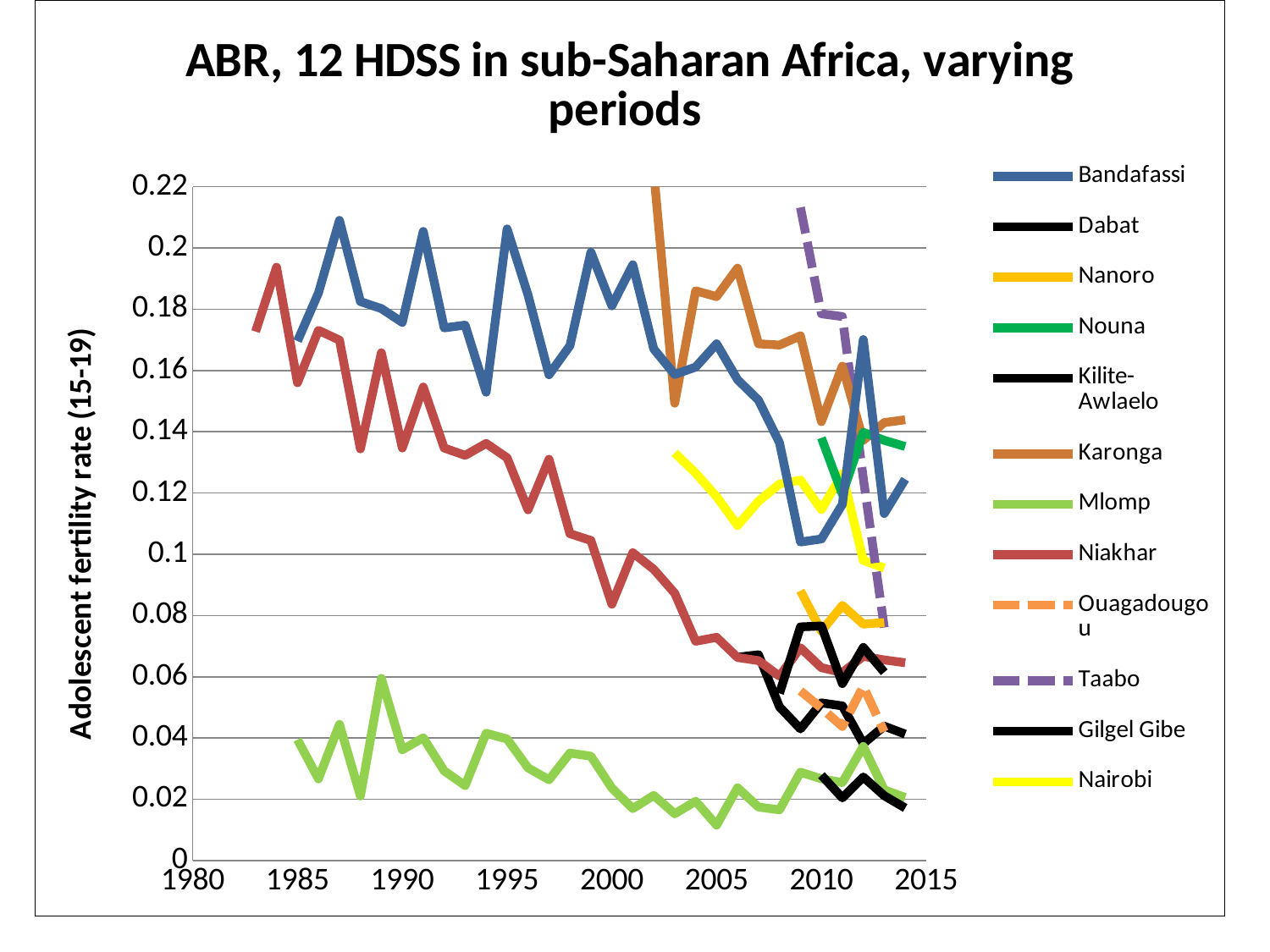
Is the value for Niakhar in 1984 greater or less than 0.18? greater Is the value for Nairobi in 2003 greater or less than 0.12? greater In 2000, which series has the larger value, Bandafassi or Niakhar? Bandafassi Is the value for Bandafassi in 2009 greater or less than 0.12? less What kind of chart is shown on the slide? Line chart Does the Niakhar series rise or fall over time from 1984 to 2014? Fall Which series has the lowest values across the chart? Mlomp What is the label of the vertical axis? Adolescent fertility rate (15-19) In 1990, which series has the larger value, Niakhar or Mlomp? Niakhar How many series does the legend list? 12 What is the title of the chart? ABR, 12 HDSS in sub-Saharan Africa, varying periods